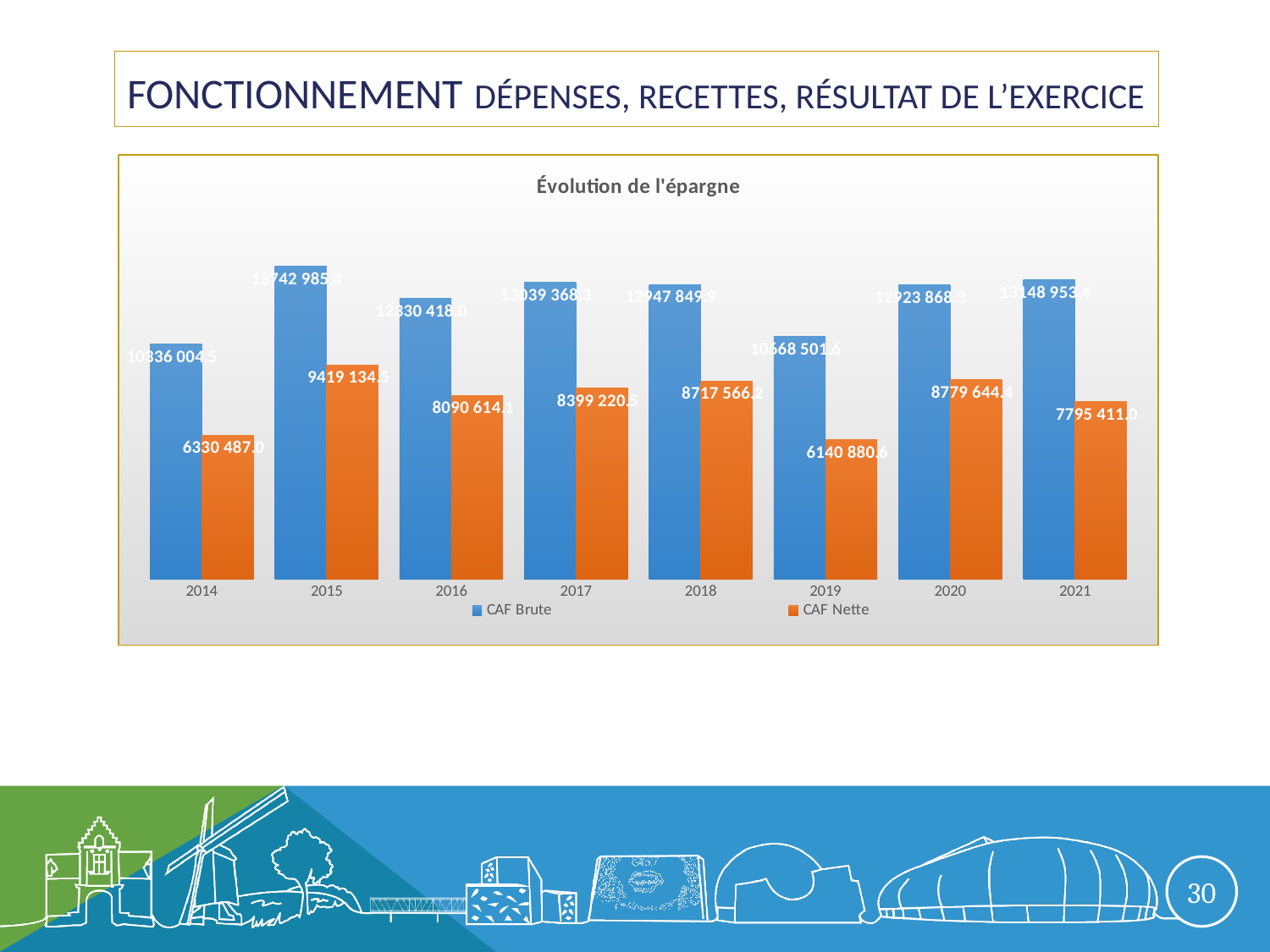
What type of chart is shown on the slide? Bar chart Which is larger, CAF Nette in 2020 or CAF Nette in 2021? CAF Nette in 2020 In which year is CAF Nette highest? 2015 In which year is CAF Nette lowest? 2019 What is the title of the chart? Évolution de l'épargne How many series does the legend list? 2 In which year is CAF Brute highest? 2015 What is the CAF Nette value for 2019? 6140 880.6 What is the CAF Nette value for 2016? 8090 614.1 What is the difference between CAF Nette in 2020 and CAF Nette in 2021? 984 233.4 How many years are shown on the x axis? 8 What is the CAF Brute value for 2021? 13148 953.4